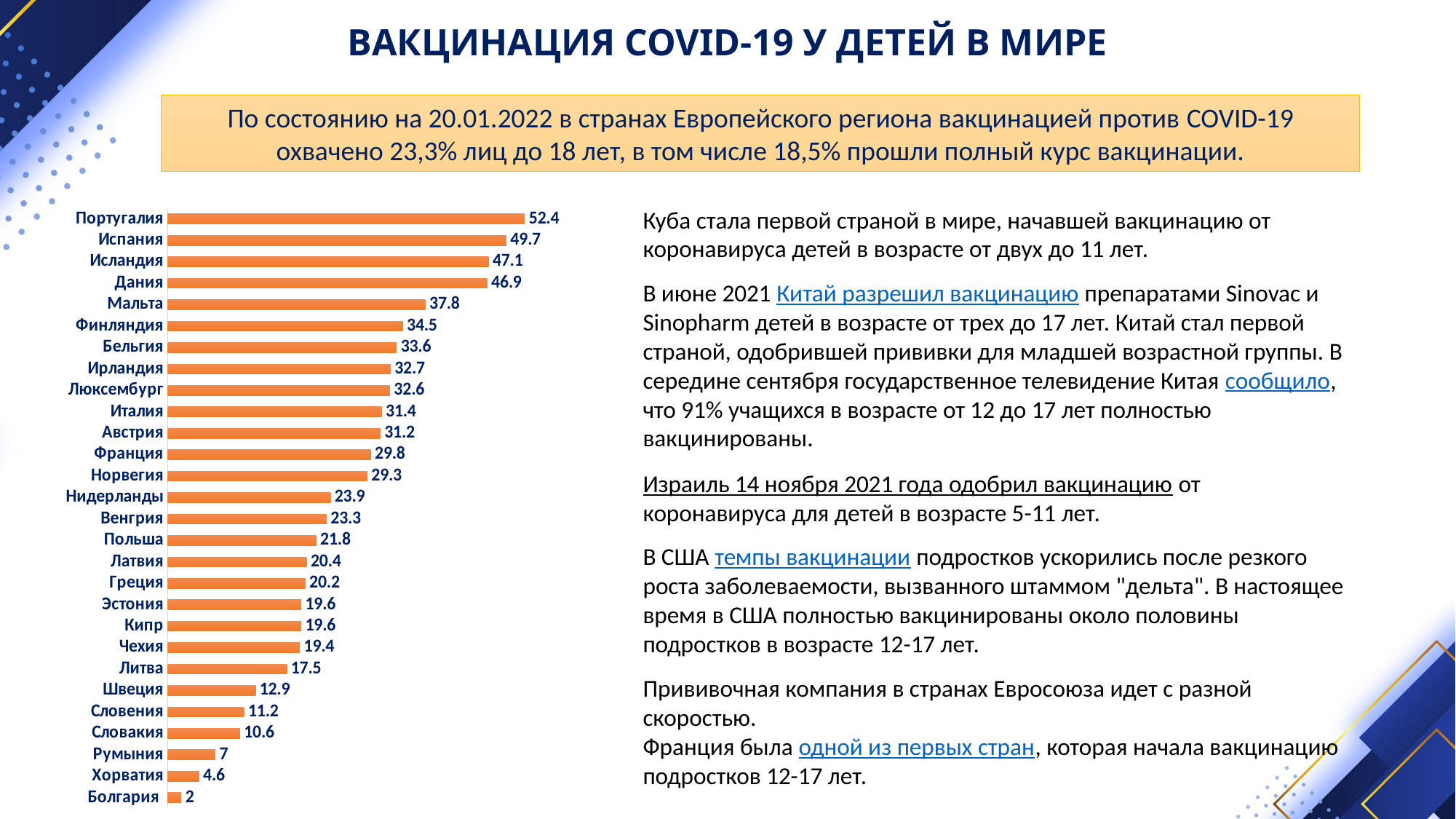
How many countries are shown in the bar chart? 28 What is the difference between the values for Португалия and Болгария? 50.4 What kind of chart is shown on the slide? Bar chart Which has a larger value, Румыния or Словакия? Словакия Which has a larger value, Мальта or Финляндия? Мальта What colour are the bars in the chart? Orange What is the difference between the values for Испания and Исландия? 2.6 What is the value for Италия in the bar chart? 31.4 What is the value for Португалия in the bar chart? 52.4 Which country has the lowest value in the bar chart? Болгария Which country has the highest value in the bar chart? Португалия What is the value for Швеция in the bar chart? 12.9